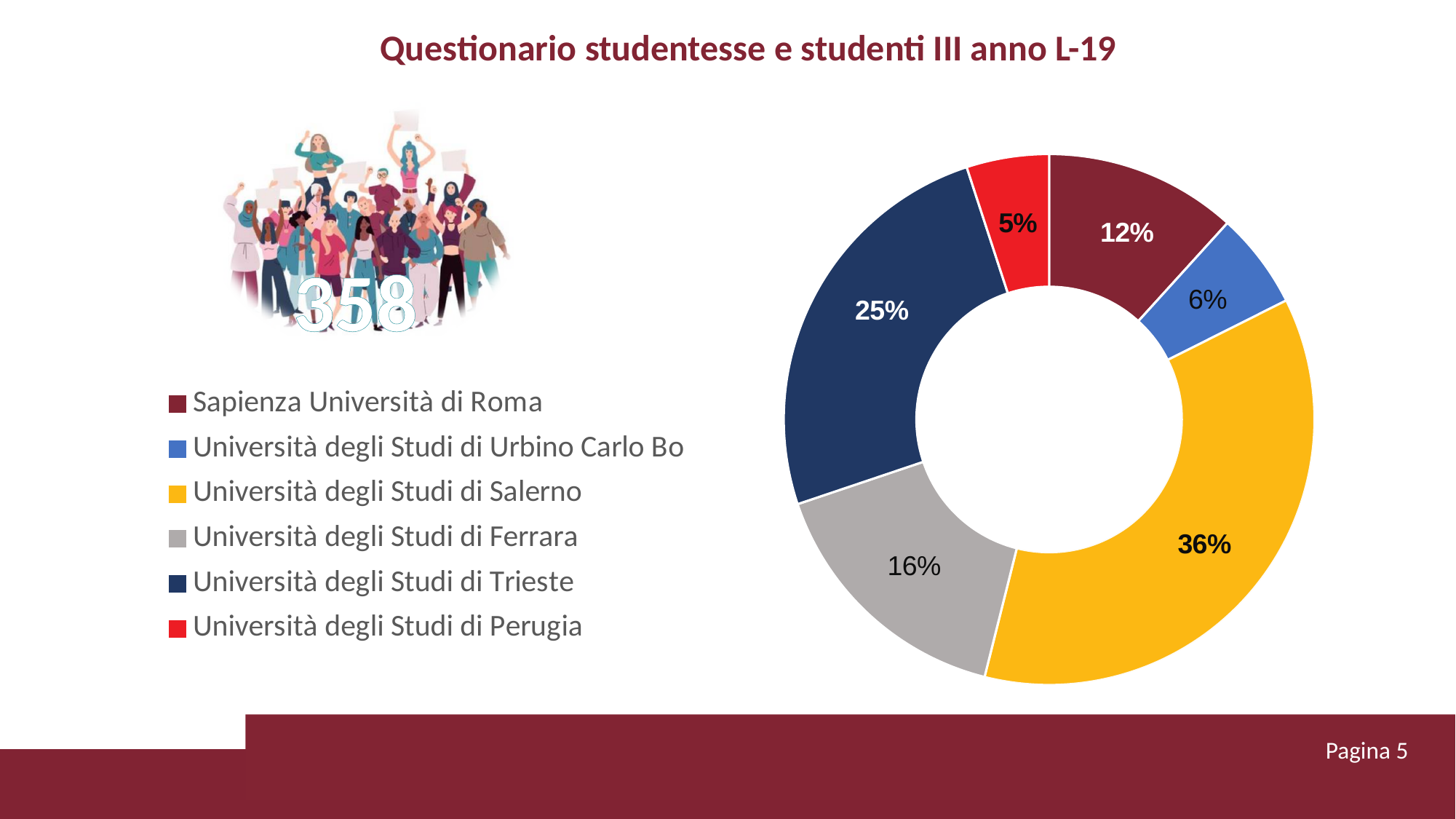
What is the value shown for Sapienza Università di Roma? 12% Which has a larger share, Università degli Studi di Ferrara or Sapienza Università di Roma? Università degli Studi di Ferrara What is the value shown for Università degli Studi di Perugia? 5% What share of the pie does Università degli Studi di Salerno have? 36% What is the value shown for Università degli Studi di Trieste? 25% What is the difference between the shares of Università degli Studi di Salerno and Università degli Studi di Trieste? 11% What colour is the slice for Università degli Studi di Urbino Carlo Bo? Blue What is the title of the slide? Questionario studentesse e studenti III anno L-19 Which university has the largest share of the pie? Università degli Studi di Salerno How many universities are shown in the chart? 6 Which university has the smallest share of the pie? Università degli Studi di Perugia What kind of chart is shown on the slide? Pie chart (doughnut)